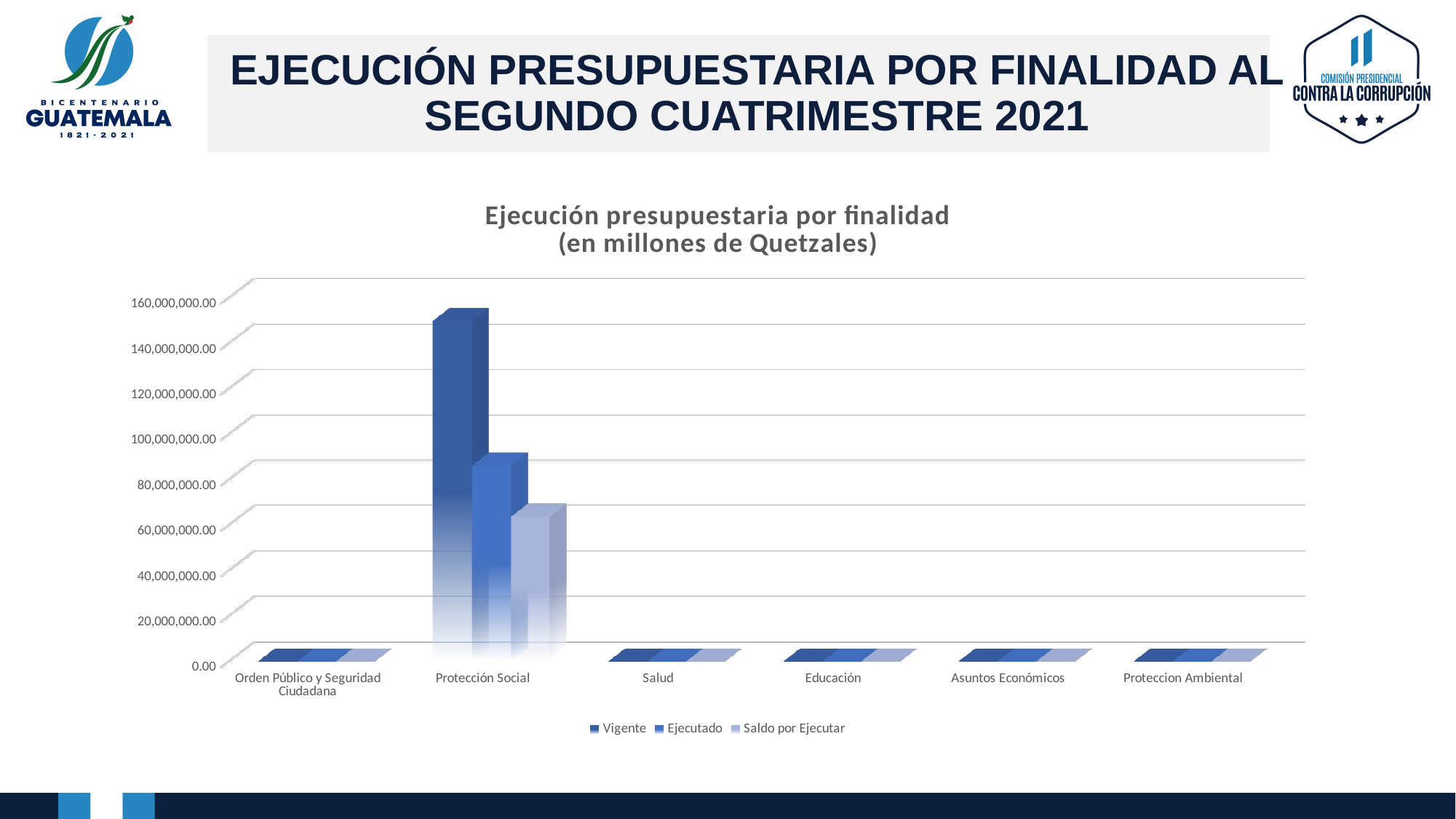
Is the Vigente value for Protección Social greater or less than 120,000,000.00? greater Which category has the highest Vigente value? Protección Social What kind of chart is shown on the slide? bar chart For Protección Social, which is larger: Ejecutado or Saldo por Ejecutar? Ejecutado How many series does the chart legend list? 3 Is the Vigente value for Protección Social greater or less than 160,000,000.00? less Is the Saldo por Ejecutar value for Protección Social greater or less than 40,000,000.00? greater What is the title of the chart? Ejecución presupuestaria por finalidad (en millones de Quetzales) How many categories are shown on the x axis of the chart? 6 Which category has the highest Ejecutado value? Protección Social For Protección Social, which is larger: Vigente or Ejecutado? Vigente